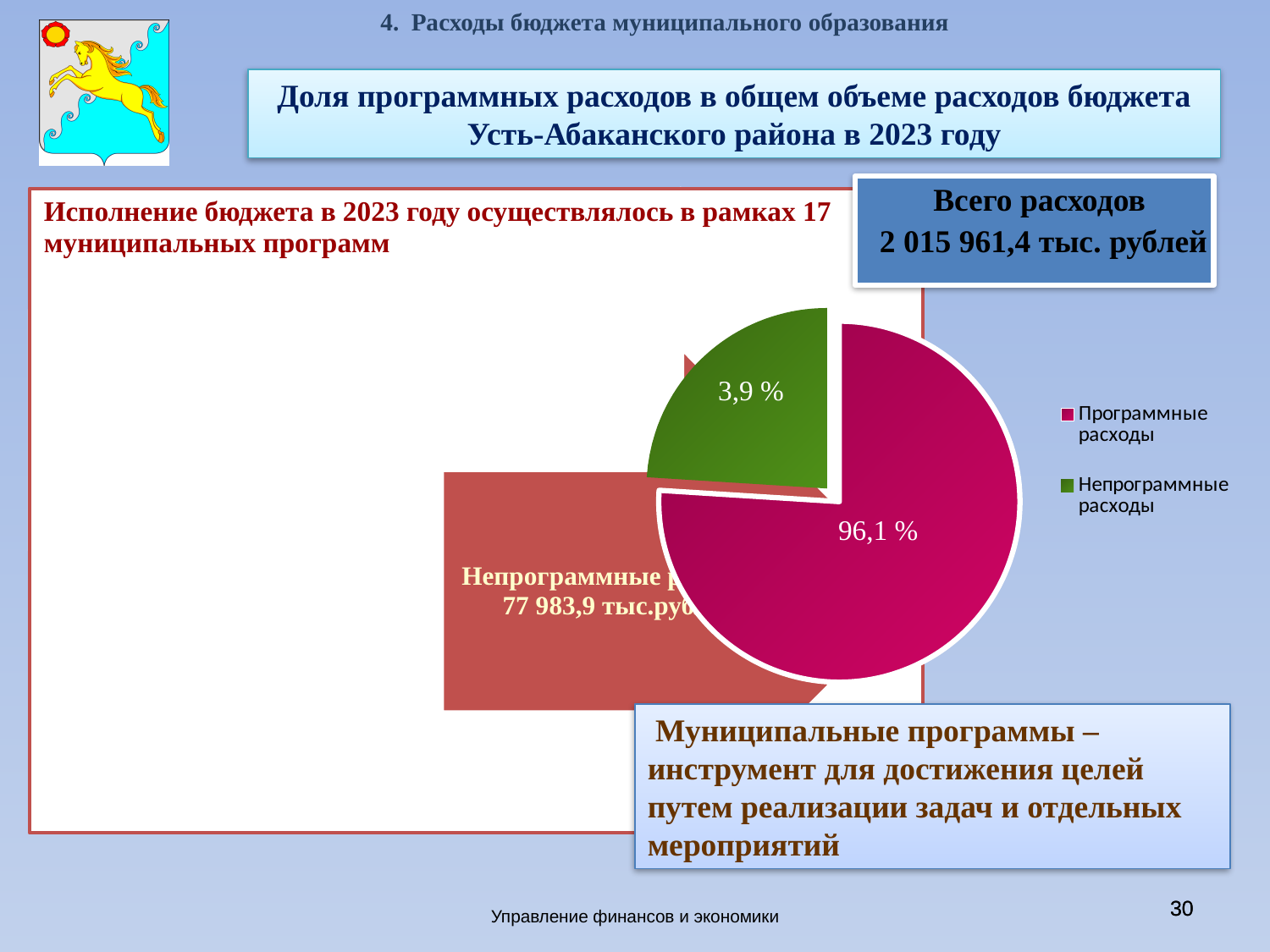
What share of the pie is labelled for Программные расходы? 96,1 % Which slice of the pie chart is the smallest? Непрограммные расходы What share of the pie is labelled for Непрограммные расходы? 3,9 % Which is larger in the pie chart: Программные расходы or Непрограммные расходы? Программные расходы What colour is the Непрограммные расходы slice in the pie chart? green What colour is the Программные расходы slice in the pie chart? magenta (crimson) How many slices does the pie chart have? 2 Which slice of the pie chart is the largest? Программные расходы What is the difference in percentage points between the Программные расходы slice and the Непрограммные расходы slice? 92,2 What kind of chart is shown on the slide? pie chart How many entries does the legend of the pie chart list? 2